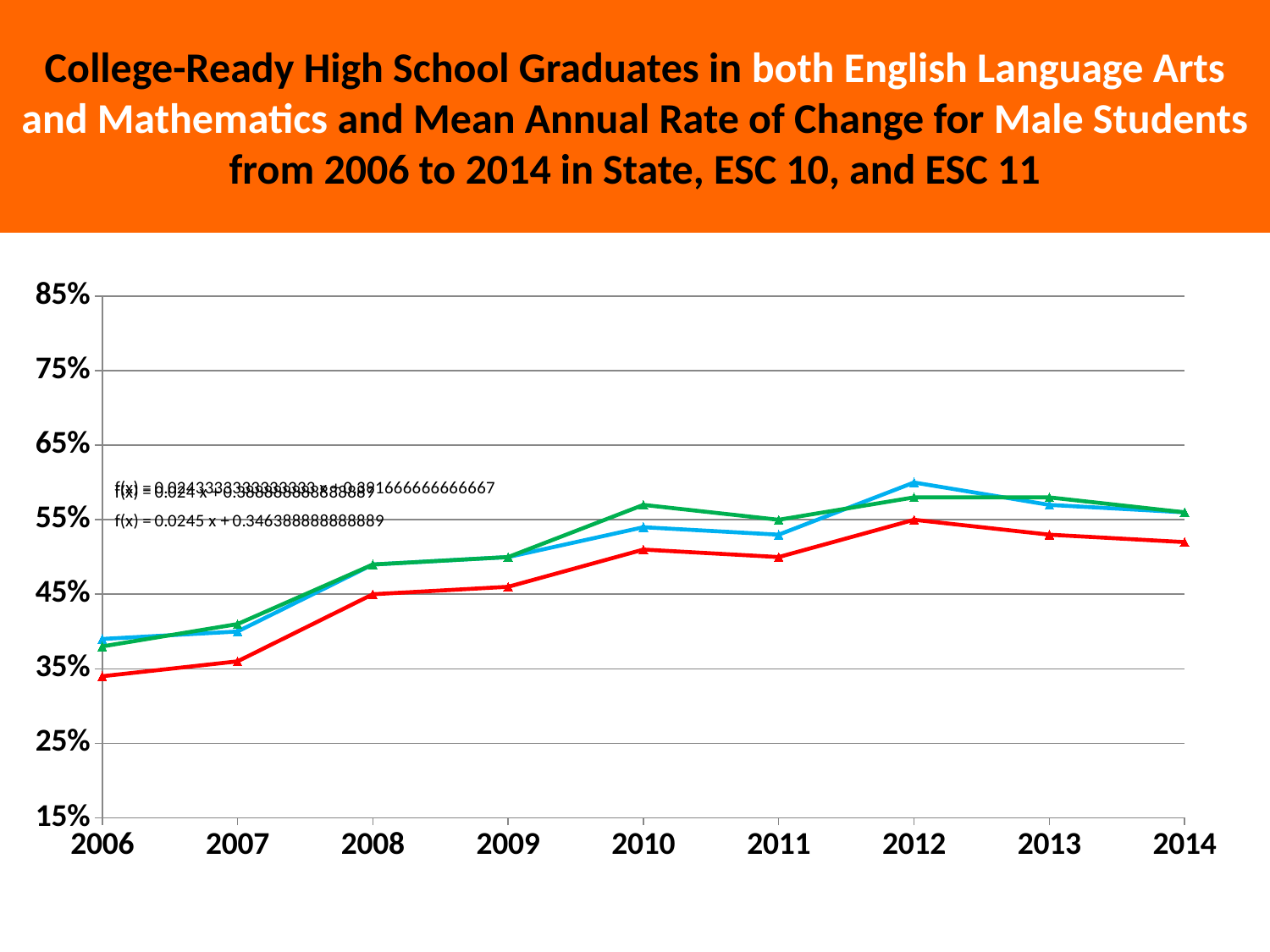
In which year does the blue line reach its highest value? 2012 In which year does the red line have its lowest value? 2006 What kind of chart is shown on the slide? line chart Is the value of the red line in 2014 greater or less than 55%? less In 2010, which line is higher, the green line or the red line? green line Does the red line rise or fall from 2006 to 2012? rise For the red line, which year has the higher value, 2012 or 2014? 2012 Is the value of the blue line in 2012 greater or less than 55%? greater What is the highest percentage shown on the y axis of the chart? 85% How many years are plotted along the x axis of the chart? 9 Is the value of the red line in 2006 greater or less than 45%? less